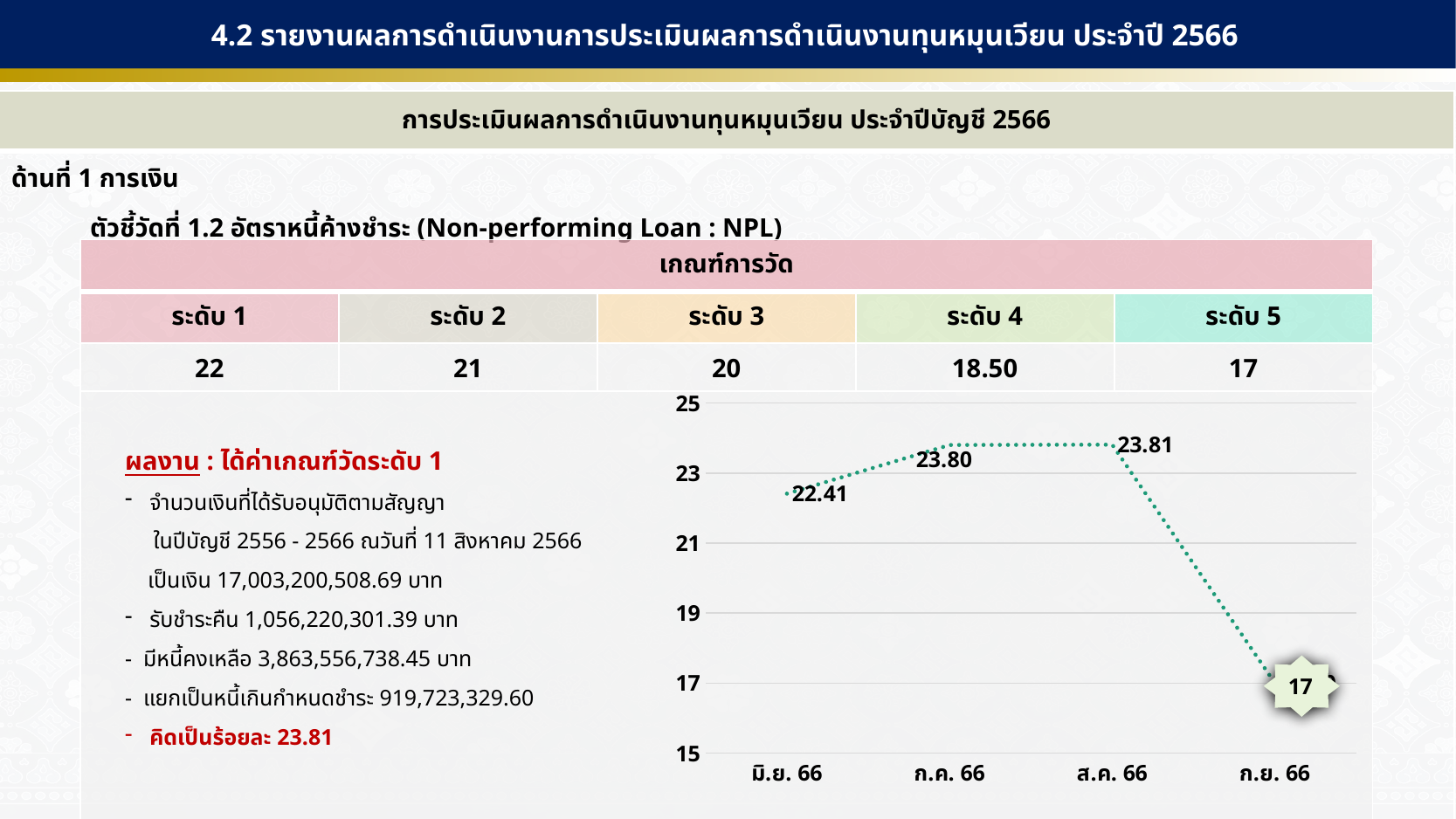
What is the value for ก.ย. 66? 17 What is the value for มิ.ย. 66? 22.41 What is the difference between the values for ก.ค. 66 and มิ.ย. 66? 1.39 Which is larger, the value for มิ.ย. 66 or the value for ก.ค. 66? ก.ค. 66 Is the value for มิ.ย. 66 greater or less than 21? greater What is the difference between the values for ส.ค. 66 and ก.ย. 66? 6.81 What is the value for ก.ค. 66? 23.80 What is the highest value shown on the y axis of the chart? 25 Which month has the lowest value on the chart? ก.ย. 66 What type of chart is shown on the slide? line chart How many data points are plotted on the chart? 4 What is the value for ส.ค. 66? 23.81